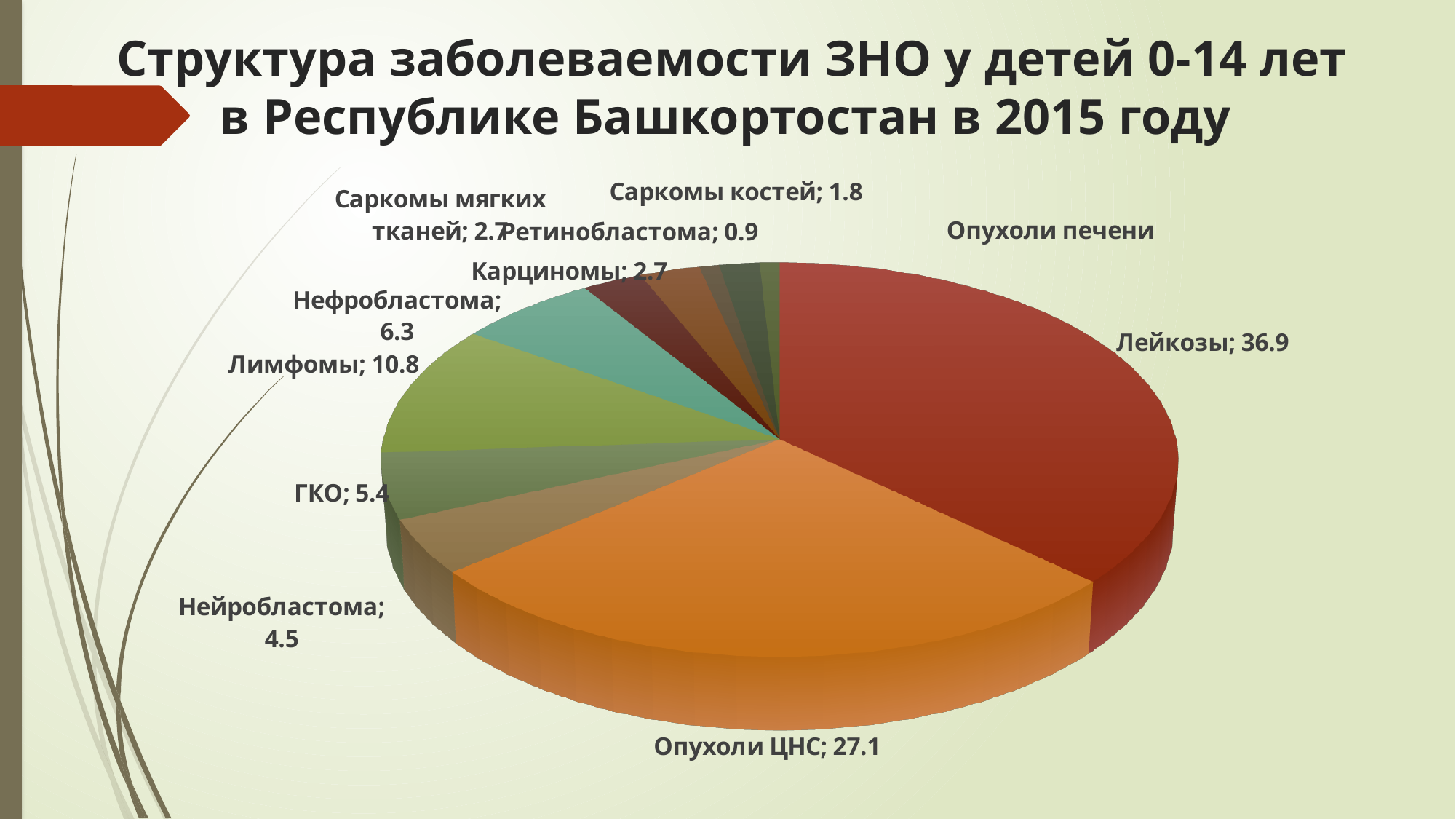
Which category has the largest slice of the pie? Лейкозы What is the value shown for Лейкозы? 36.9 What is the value shown for Опухоли ЦНС? 27.1 How many categories are labelled on the pie chart? 11 What is the difference between the values for Лимфомы and Нефробластома? 4.5 What kind of chart is shown on the slide? pie chart What is the difference between the values for Лейкозы and Опухоли ЦНС? 9.8 What is the value shown for Нефробластома? 6.3 What is the value shown for Лимфомы? 10.8 What is the title of the slide? Структура заболеваемости ЗНО у детей 0-14 лет в Республике Башкортостан в 2015 году What is the value shown for Ретинобластома? 0.9 Which is larger, the value for ГКО or the value for Нейробластома? ГКО